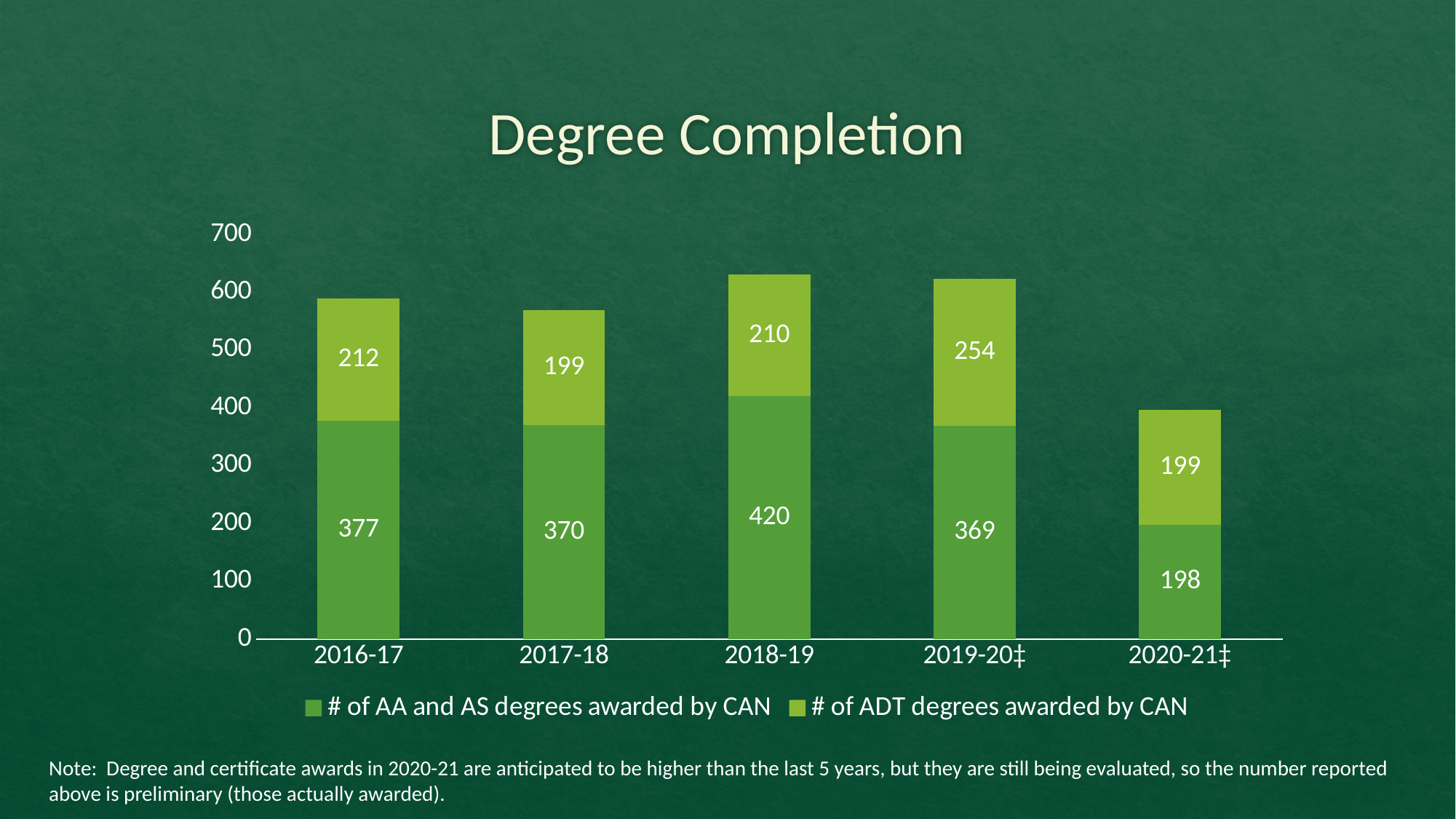
What is the difference between the number of AA and AS degrees awarded in 2018-19 and in 2017-18? 50 What is the total number of degrees in the stacked bar for 2020-21‡? 397 Which year has the lowest number of AA and AS degrees awarded by CAN? 2020-21‡ What is the total number of degrees in the stacked bar for 2019-20‡? 623 What is the number of AA and AS degrees awarded by CAN in 2018-19? 420 Which is larger: the number of ADT degrees awarded in 2016-17 or in 2018-19? 2016-17 What is the number of AA and AS degrees awarded by CAN in 2020-21‡? 198 How many series does the legend list? 2 What is the number of ADT degrees awarded by CAN in 2019-20‡? 254 What kind of chart is shown on the slide? Stacked bar chart How many years are shown on the x axis? 5 Which year has the highest number of ADT degrees awarded by CAN? 2019-20‡